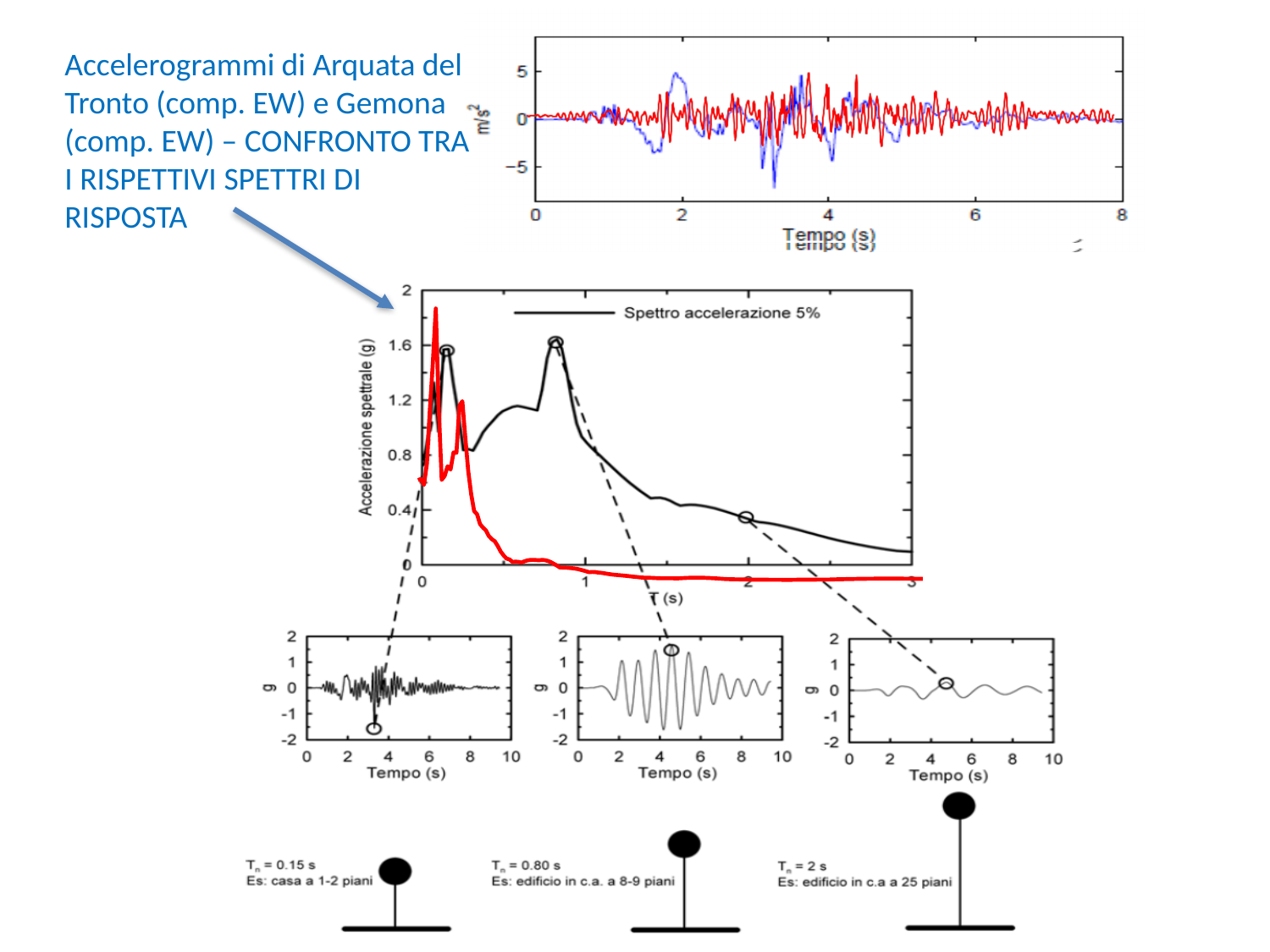
In the middle spectrum chart, is the value of the black curve at T = 3 s greater or less than 0.4? less In the middle spectrum chart, does the black curve rise or fall as T increases from 1 s to 3 s? fall In the middle spectrum chart, is the value of the red curve at T = 2 s greater or less than 0.4? less In the top accelerogram chart, is the lowest value of the blue trace greater or less than -5? less In the middle spectrum chart, what is the y-axis label? Accelerazione spettrale (g) In the middle spectrum chart, what is the legend entry? Spettro accelerazione 5% In the middle spectrum chart, which curve is higher at T = 0.5 s, the black curve or the red curve? black curve What kind of chart is the middle chart with the legend 'Spettro accelerazione 5%'? line chart How many small time-history charts with 'Tempo (s)' on the x axis are shown in the bottom row of the slide? 3 In the middle spectrum chart, how many entries does the legend list? 1